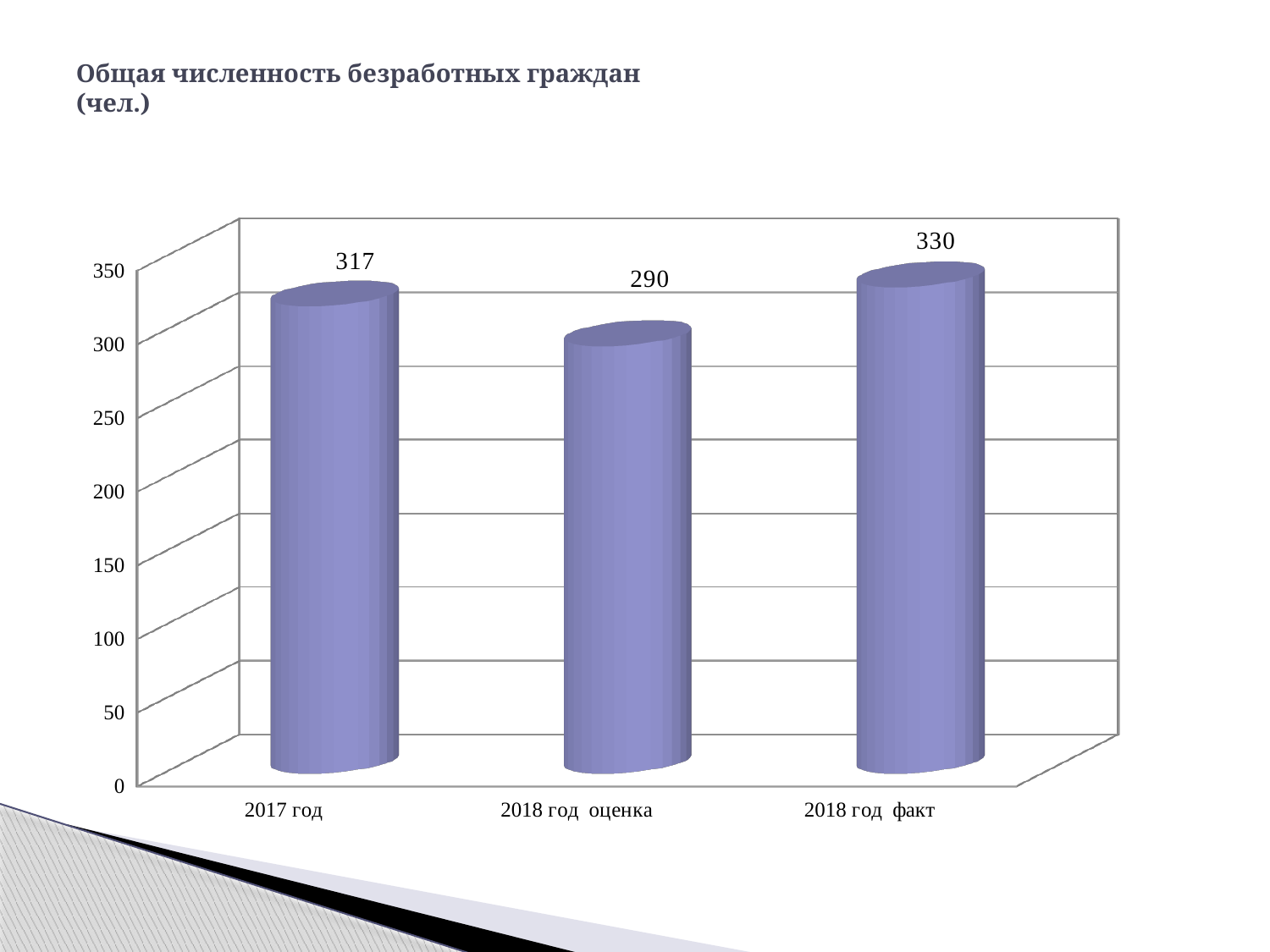
Which category has the lowest value? 2018 год оценка What is the difference between the values for 2017 год and 2018 год оценка? 27 Which category has the highest value? 2018 год факт What is the difference between the values for 2018 год факт and 2018 год оценка? 40 What is the value for 2017 год? 317 Is the value for 2018 год оценка greater or less than 300? less What kind of chart is shown on the slide? bar chart What is the value for 2018 год факт? 330 What is the title of the chart? Общая численность безработных граждан (чел.) Which is larger, the value for 2017 год or the value for 2018 год факт? 2018 год факт What is the value for 2018 год оценка? 290 How many categories are shown on the chart? 3